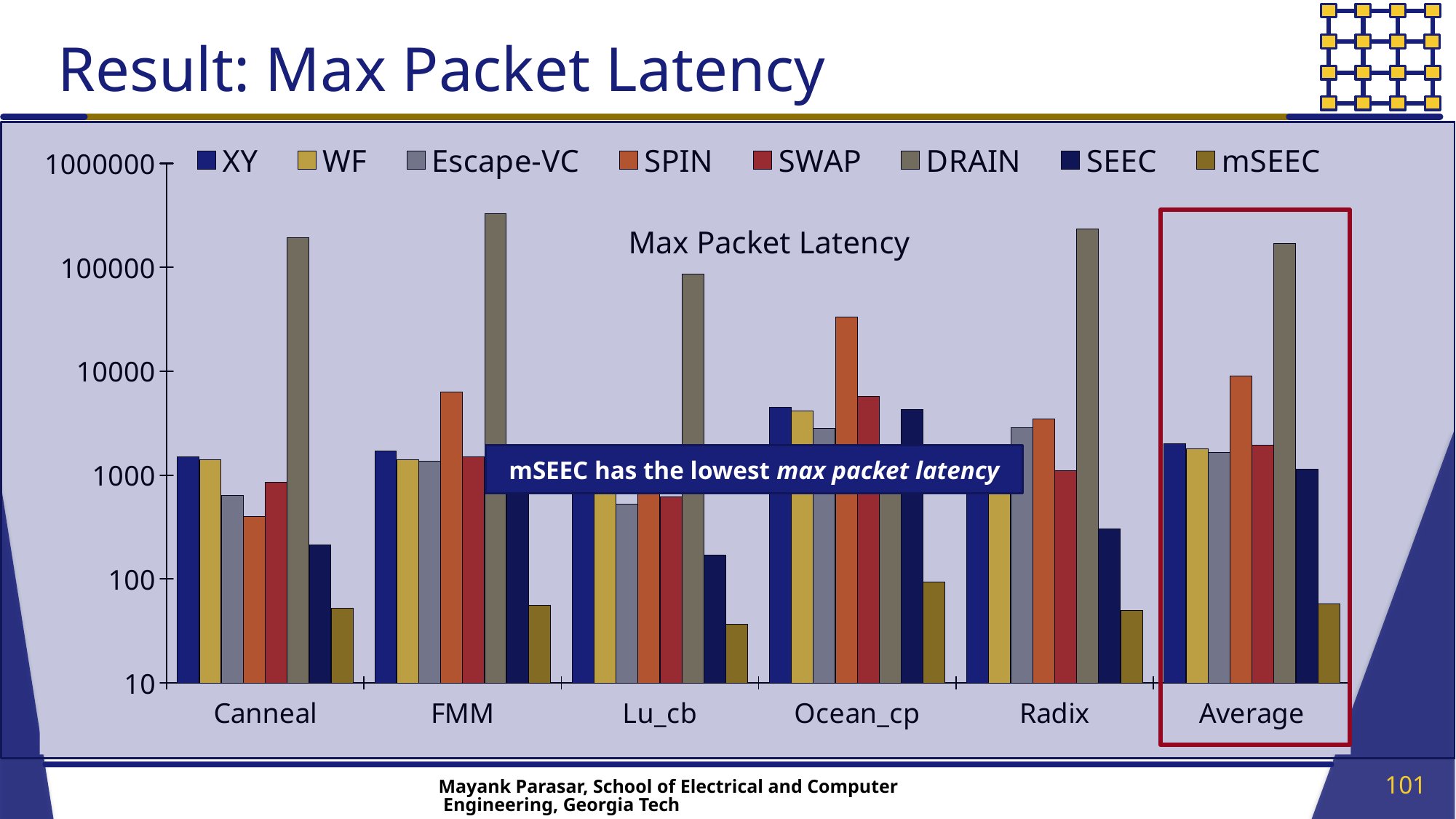
For Radix, which is larger: SEEC or mSEEC? SEEC Which category on the x axis is highlighted with a red box? Average For Canneal, which series has the highest max packet latency? DRAIN Which category has the highest DRAIN value? FMM For Ocean_cp, which is larger: SPIN or SWAP? SPIN Is the mSEEC value for Lu_cb greater or less than 100? less Is the DRAIN value for FMM greater or less than 100000? greater Is the SPIN value for Ocean_cp greater or less than 10000? greater For Average, which series has the lowest max packet latency? mSEEC How many benchmark categories are shown along the x axis? 6 How many series does the legend list? 8 What kind of chart is shown on the slide? bar chart